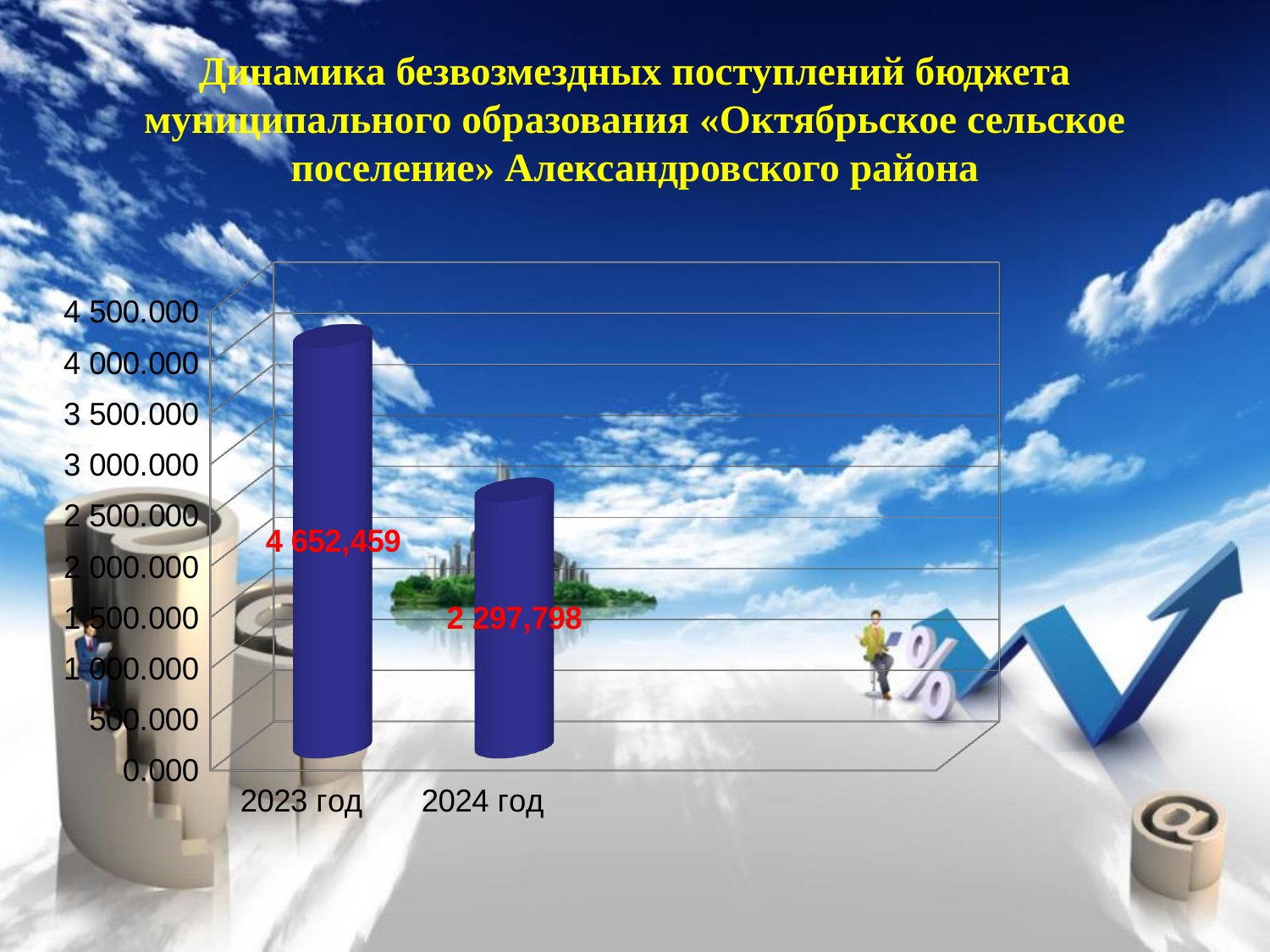
Do the values rise or fall from 2023 год to 2024 год? fall What is the value shown for 2024 год? 2 297,798 How many categories (years) are shown on the chart? 2 What kind of chart is shown on the slide? bar chart What is the value shown for 2023 год? 4 652,459 Which year has the lower value? 2024 год What is the difference between the values for 2023 год and 2024 год? 2 354,661 What is the highest labelled value on the vertical axis? 4 500.000 Which year has the higher value? 2023 год Is the value for 2024 год larger or smaller than the value for 2023 год? smaller